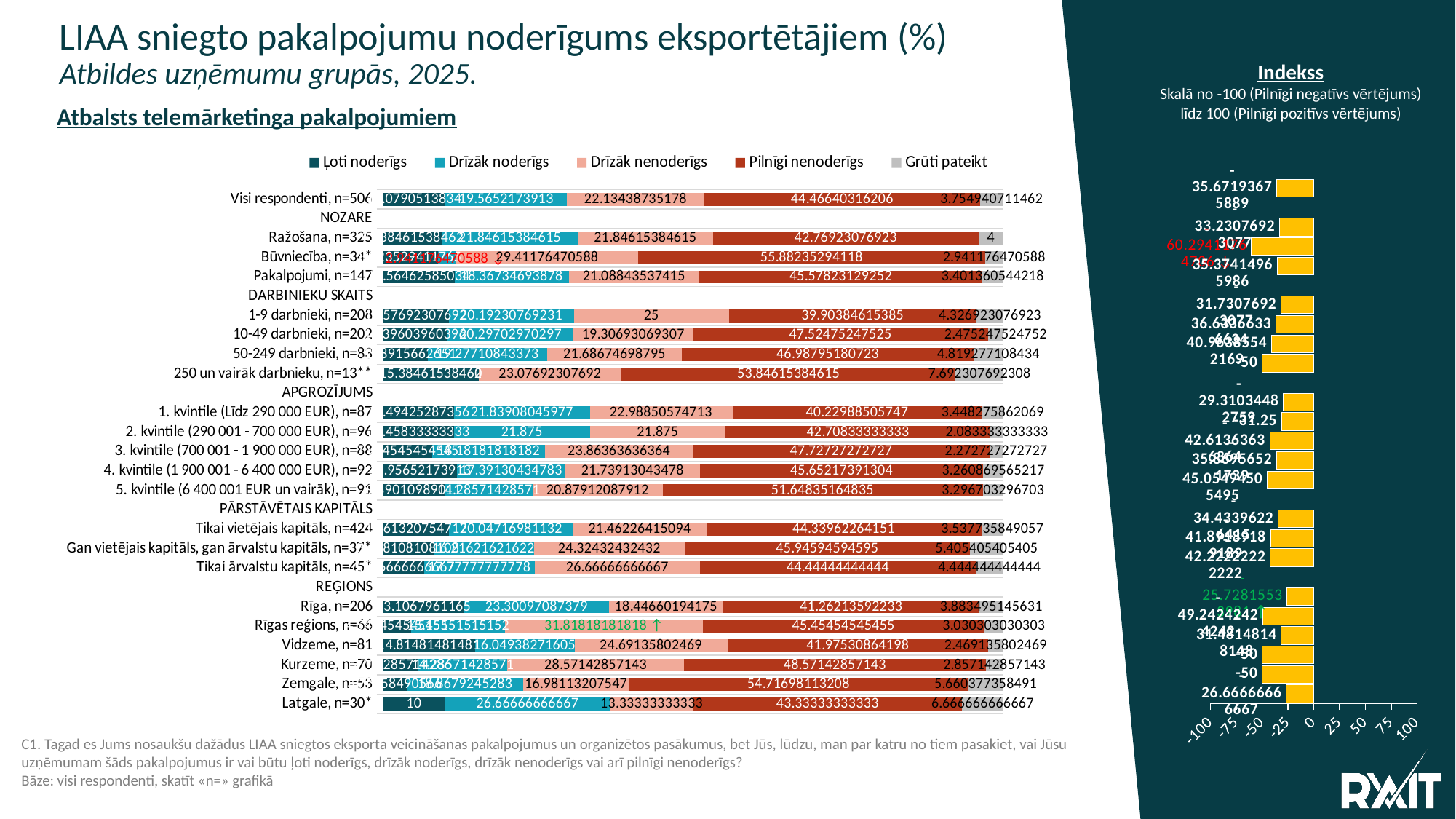
In the main chart, what is the 'Pilnīgi nenoderīgs' value for 'Visi respondenti, n=506'? 44.46640316206 In the main chart, what is the difference between the 'Pilnīgi nenoderīgs' values of 'Kurzeme, n=70' and 'Vidzeme, n=81'? 6.59611992945 In the main chart, what is the 'Grūti pateikt' value for 'Ražošana, n=325'? 4 In the main chart, which category has the highest 'Pilnīgi nenoderīgs' value? Būvniecība, n=34* In the main chart, what is the 'Ļoti noderīgs' value for 'Latgale, n=30*'? 10 In the main chart, what is the 'Drīzāk nenoderīgs' value for '1-9 darbinieki, n=208'? 25 How many series does the legend of the main chart list? 5 In the main chart, what is the 'Drīzāk nenoderīgs' value for 'Rīgas reģions, n=66'? 31.81818181818 What type of chart is the main chart on the slide? Stacked bar chart What scale does the 'Indekss' chart on the right use, according to its subtitle? From -100 to 100 In the main chart, is the 'Pilnīgi nenoderīgs' value larger for 'Zemgale, n=53' or for 'Rīga, n=206'? Zemgale, n=53 In the main chart, which region has the lowest 'Drīzāk nenoderīgs' value? Latgale, n=30*